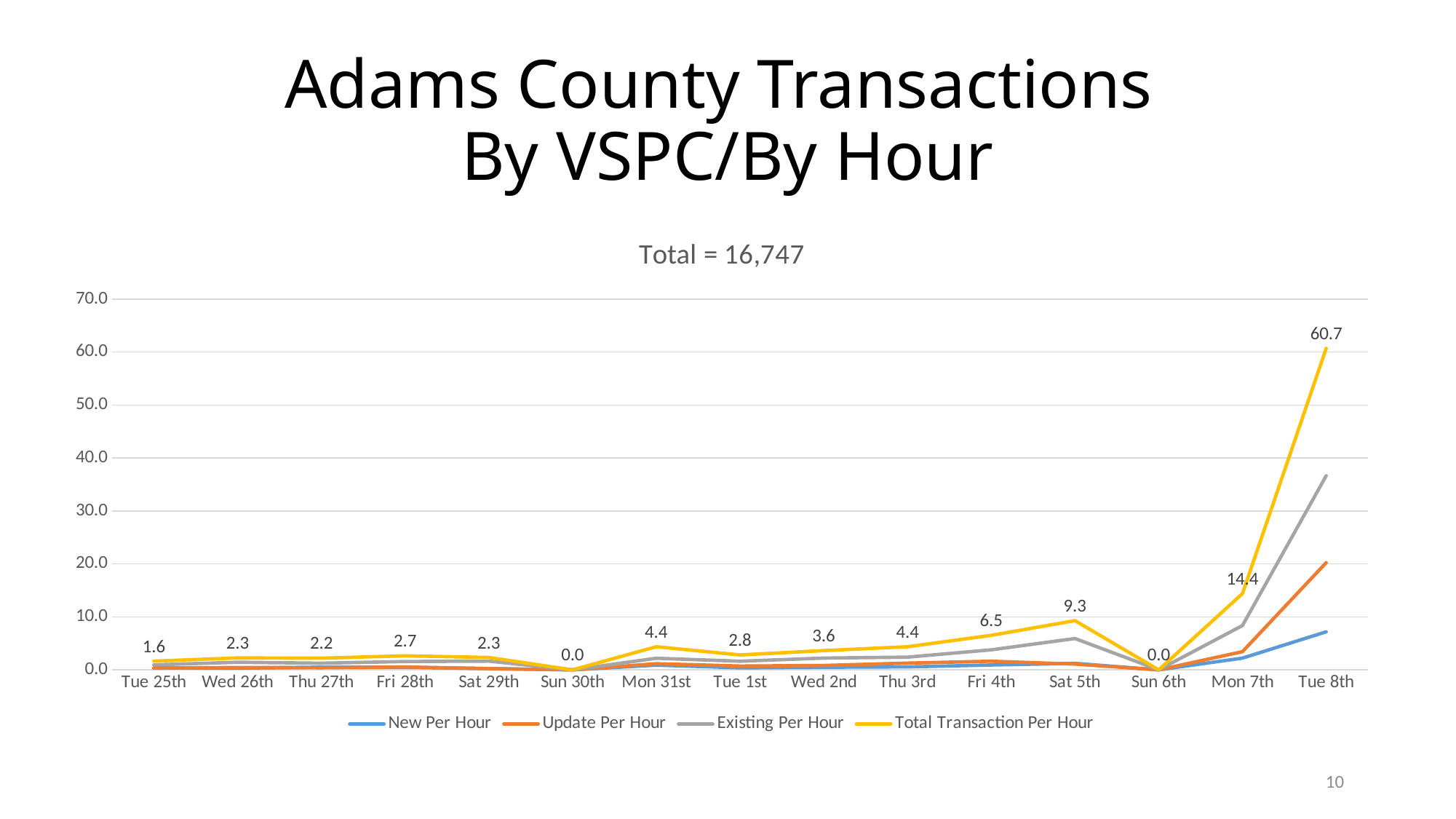
What is the Total Transaction Per Hour value for Sat 5th? 9.3 What is the Total Transaction Per Hour value for Tue 8th? 60.7 Which is larger, the Total Transaction Per Hour on Fri 4th or on Wed 2nd? Fri 4th What total is stated in the subtitle above the chart? Total = 16,747 On which date is Total Transaction Per Hour highest? Tue 8th What is the Total Transaction Per Hour value for Mon 7th? 14.4 How many dates are shown along the x axis? 15 Is the Existing Per Hour value for Tue 8th greater or less than 30.0? greater Which series is drawn in yellow? Total Transaction Per Hour What is the difference in Total Transaction Per Hour between Tue 8th and Mon 7th? 46.3 How many series does the legend list? 4 What type of chart is shown on the slide? line chart